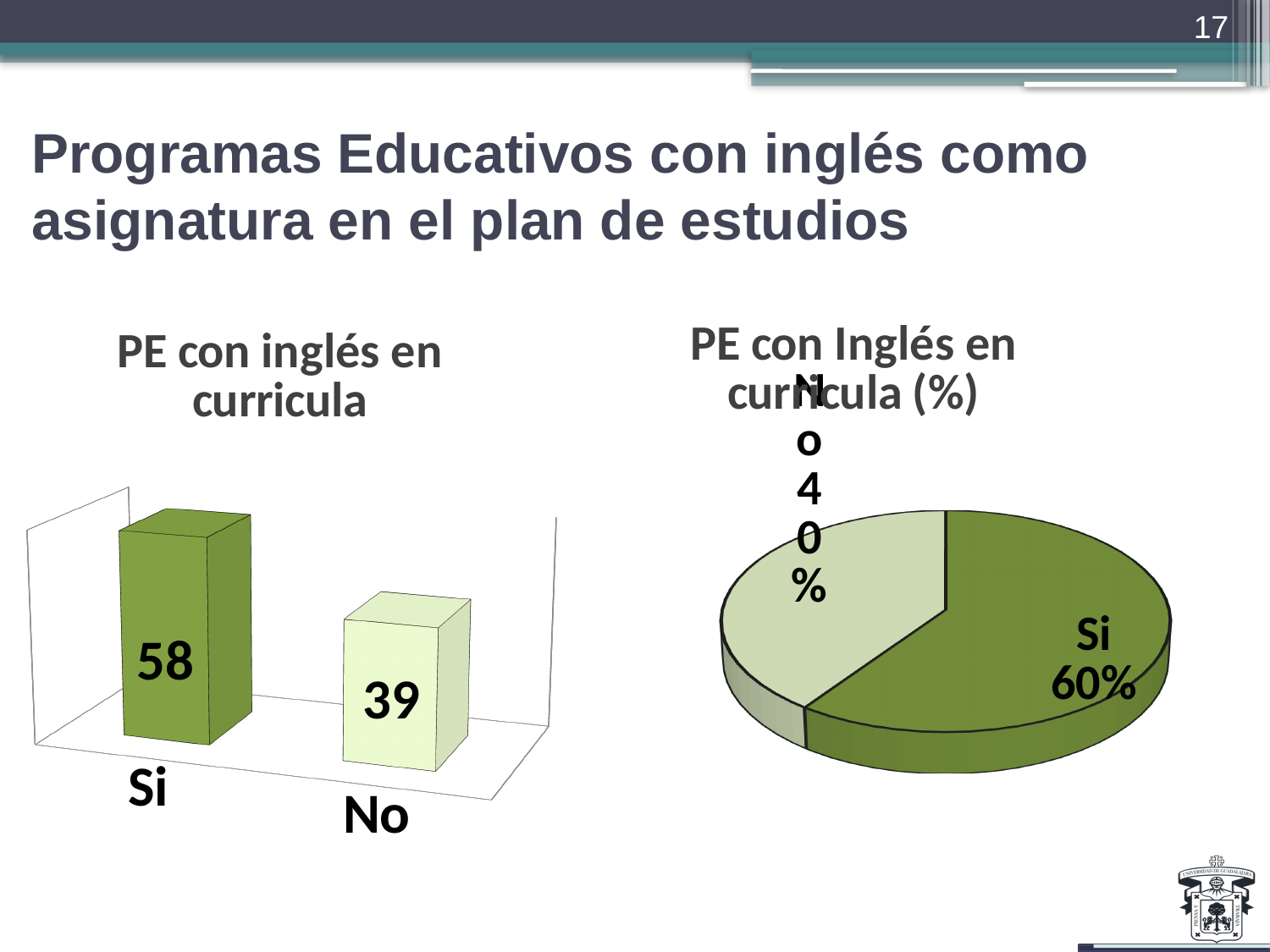
In the bar chart 'PE con inglés en curricula', which category has the highest value? Si In the bar chart 'PE con inglés en curricula', how many categories are shown? 2 In the bar chart 'PE con inglés en curricula', what is the value for No? 39 In the pie chart 'PE con Inglés en curricula (%)', what share does No have? 40% In the bar chart 'PE con inglés en curricula', what is the difference between the values for Si and No? 19 In the bar chart 'PE con inglés en curricula', which category has the lowest value? No In the bar chart 'PE con inglés en curricula', what is the value for Si? 58 What kind of chart is the chart on the right of the slide? Pie chart In the pie chart 'PE con Inglés en curricula (%)', which slice is larger, Si or No? Si In the pie chart 'PE con Inglés en curricula (%)', how many slices are there? 2 In the pie chart 'PE con Inglés en curricula (%)', what share does Si have? 60% What kind of chart is the chart on the left of the slide? Bar chart